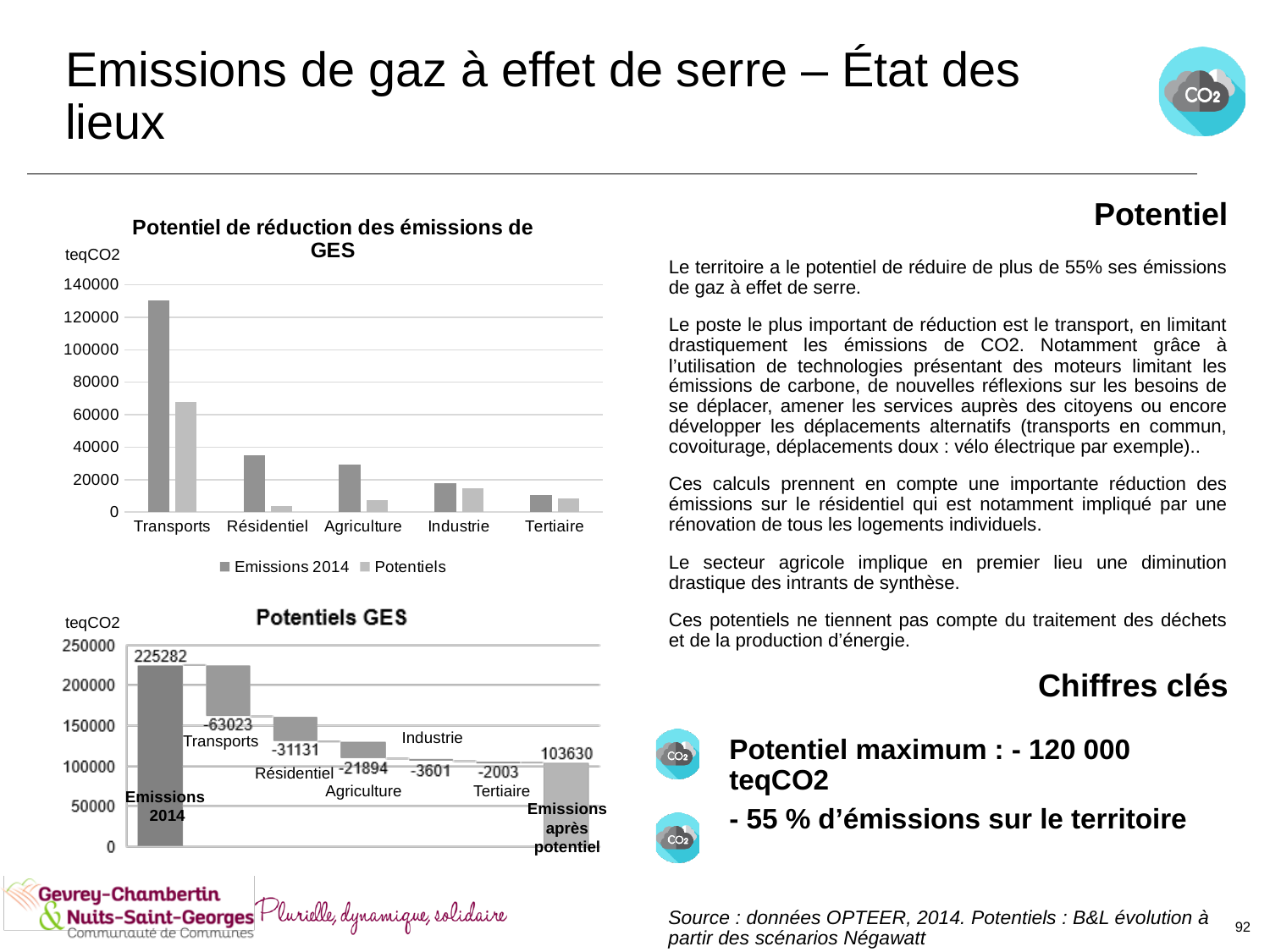
In the top chart 'Potentiel de réduction des émissions de GES', how many series does the legend list? 2 In the bottom chart 'Potentiels GES', what is the value shown for Transports? -63023 What kind of chart is the top chart titled 'Potentiel de réduction des émissions de GES'? bar chart In the bottom chart 'Potentiels GES', what is the value shown for Emissions après potentiel? 103630 In the top chart 'Potentiel de réduction des émissions de GES', which category has the highest Emissions 2014 value? Transports In the bottom chart 'Potentiels GES', what is the value shown for Emissions 2014? 225282 In the top chart 'Potentiel de réduction des émissions de GES', how many categories are shown on the x axis? 5 In the top chart 'Potentiel de réduction des émissions de GES', which is larger for Transports: Emissions 2014 or Potentiels? Emissions 2014 In the top chart 'Potentiel de réduction des émissions de GES', is the Emissions 2014 value for Transports greater or less than 120000? greater In the top chart 'Potentiel de réduction des émissions de GES', which category has the lowest Emissions 2014 value? Tertiaire In the top chart 'Potentiel de réduction des émissions de GES', is the Potentiels value for Résidentiel greater or less than 20000? less In the bottom chart 'Potentiels GES', what is the difference between Emissions 2014 and Emissions après potentiel? 121652